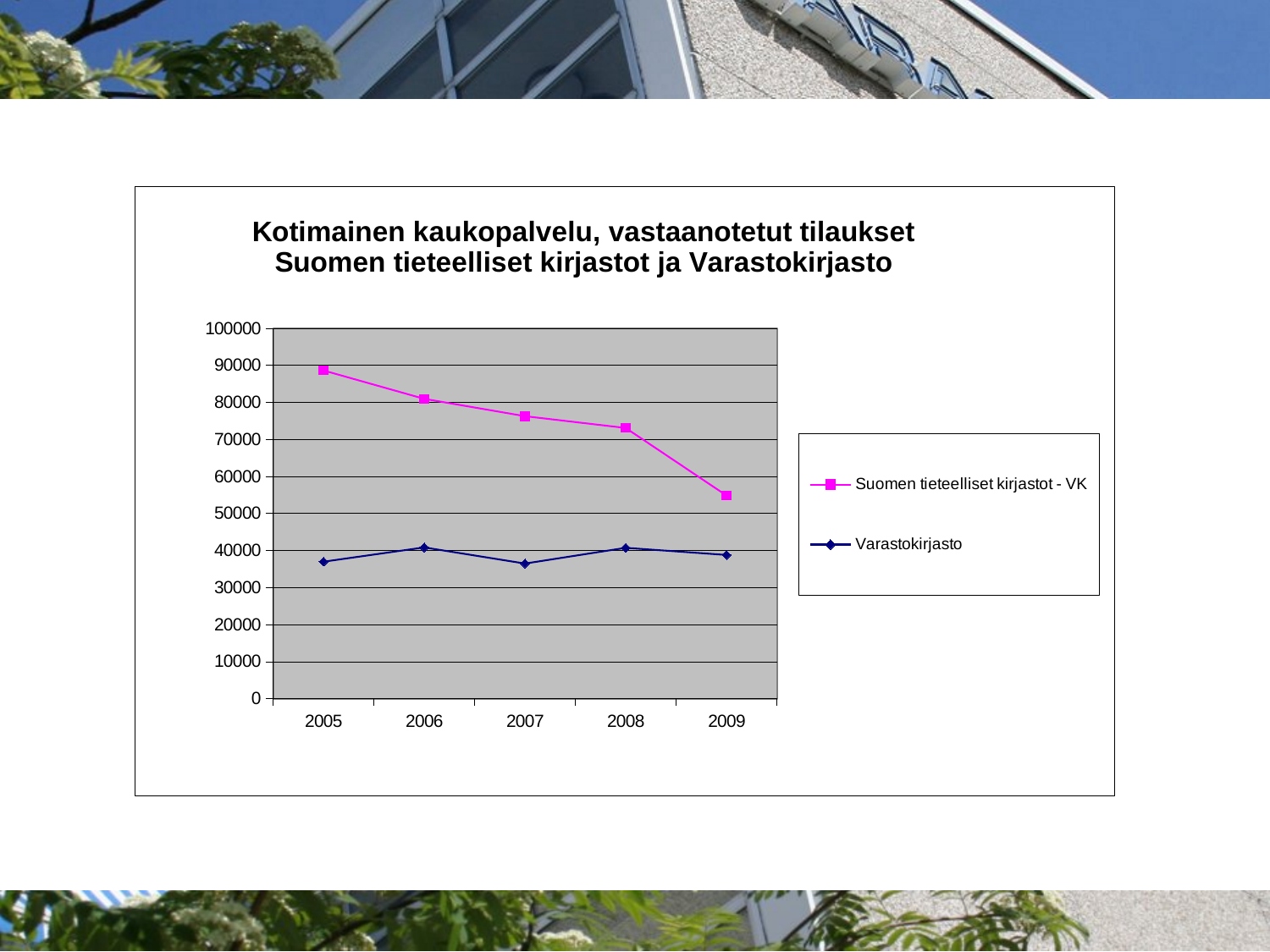
Which series has the larger value in 2009, Suomen tieteelliset kirjastot - VK or Varastokirjasto? Suomen tieteelliset kirjastot - VK Which series is drawn with the pink line and square markers? Suomen tieteelliset kirjastot - VK Does the value for Suomen tieteelliset kirjastot - VK rise or fall from 2005 to 2009? fall In which year is the value for Suomen tieteelliset kirjastot - VK lowest? 2009 What is the first line of the chart title? Kotimainen kaukopalvelu, vastaanotetut tilaukset How many series does the legend list? 2 Is the value for Suomen tieteelliset kirjastot - VK in 2009 greater or less than 60000? less What kind of chart is shown on the slide? line chart Is the value for Varastokirjasto in 2007 greater or less than 40000? less Is the value for Suomen tieteelliset kirjastot - VK in 2005 greater or less than 80000? greater In which year is the value for Suomen tieteelliset kirjastot - VK highest? 2005 How many years are shown on the x axis? 5